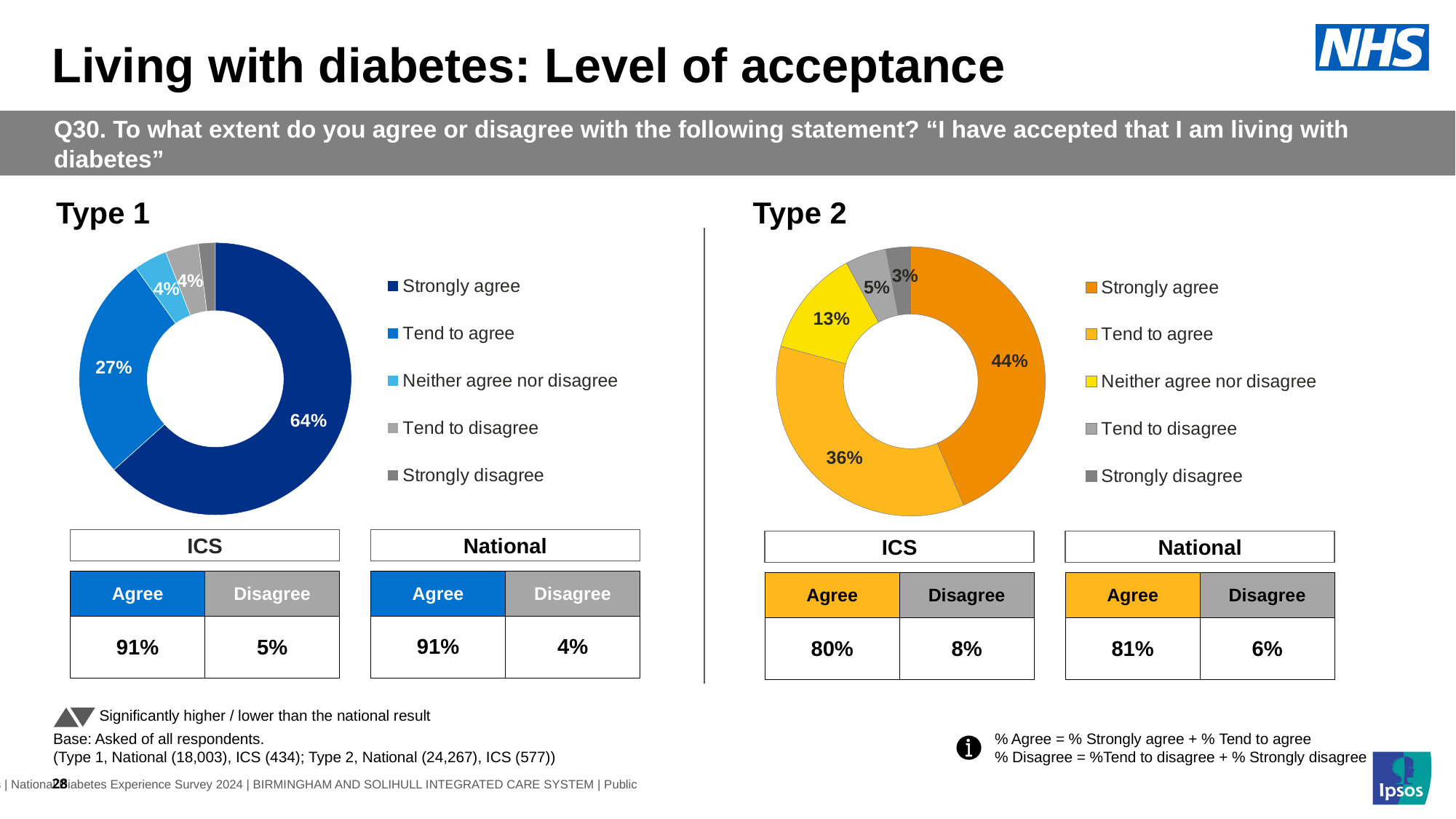
In the Type 1 chart, what is the difference between the Strongly agree and Tend to agree shares? 37% In the Type 2 chart, which response category has the smallest share? Strongly disagree In the Type 2 chart, what percentage of respondents strongly disagree? 3% Which is larger: the Strongly agree share in the Type 1 chart or the Strongly agree share in the Type 2 chart? Type 1 In the Type 2 chart, what is the difference between the Tend to agree and Neither agree nor disagree shares? 23% In the Type 1 chart, what percentage of respondents tend to agree? 27% How many response categories does the legend of the Type 2 chart list? 5 In the Type 2 chart, what percentage of respondents neither agree nor disagree? 13% In the Type 2 chart, which response category has the largest share? Strongly agree What kind of chart is used for the Type 1 results? Donut chart In the Type 1 chart, what percentage of respondents strongly agree? 64% In the Type 2 chart, what percentage of respondents strongly agree? 44%